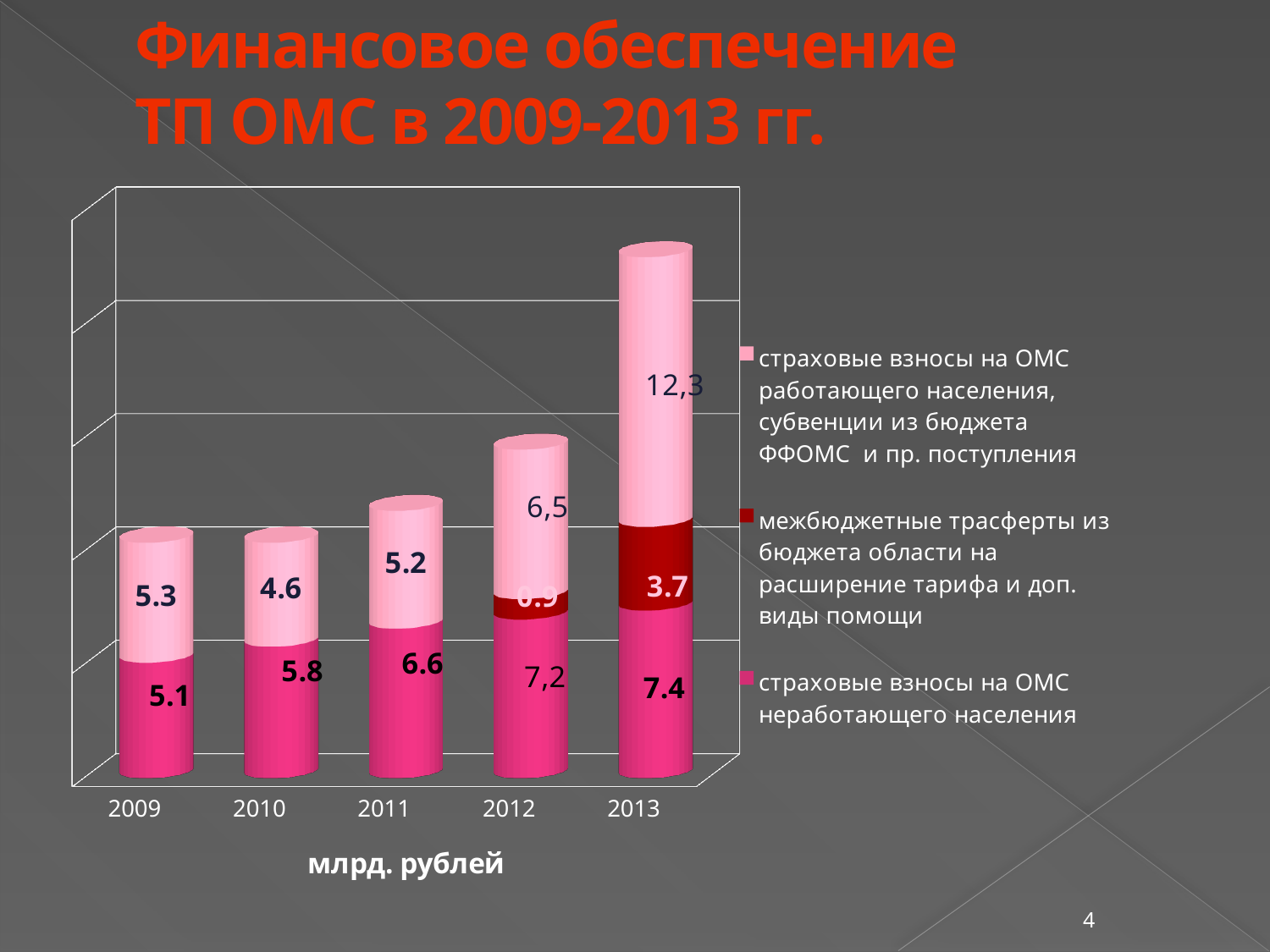
Which year has the tallest stacked bar? 2013 What is the value of the межбюджетные трасферты segment in 2012? 0.9 What is the value of the top (light pink) segment for 2013? 12,3 How many years are shown along the x axis of the chart? 5 In 2010, which is larger: the bottom segment (неработающего населения) or the top segment (работающего населения)? the bottom segment (5.8) What is the total of the stacked bar for 2012? 14,6 What kind of chart is shown on the slide? bar chart What is the difference between the 2013 and 2012 values for страховые взносы на ОМС неработающего населения? 0.2 How many series does the chart legend list? 3 What unit is given below the chart's x axis? млрд. рублей Do the values for страховые взносы на ОМС неработающего населения rise or fall from 2009 to 2013? rise What is the value for страховые взносы на ОМС неработающего населения in 2009? 5.1